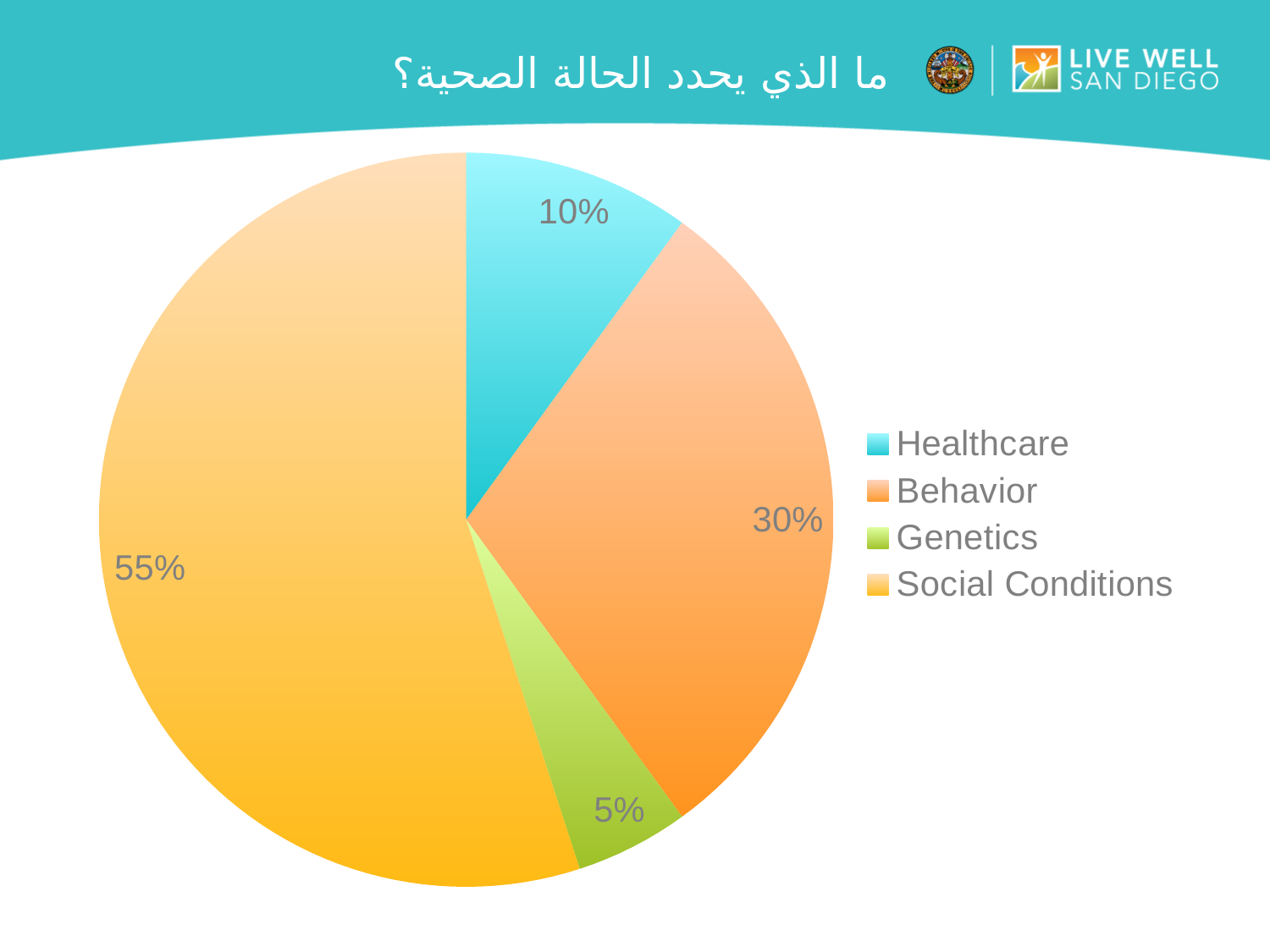
What share of the pie does Social Conditions take? 55% How many entries does the legend list? 4 What colour is the Genetics slice? green What is the value for Genetics? 5% How many slices does the pie chart have? 4 Which is larger, Healthcare or Behavior? Behavior What is the value for Behavior? 30% Which category has the largest slice? Social Conditions What kind of chart is shown on the slide? pie chart What is the value for Healthcare? 10% Which category has the smallest slice? Genetics What is the difference between Social Conditions and Behavior? 25%